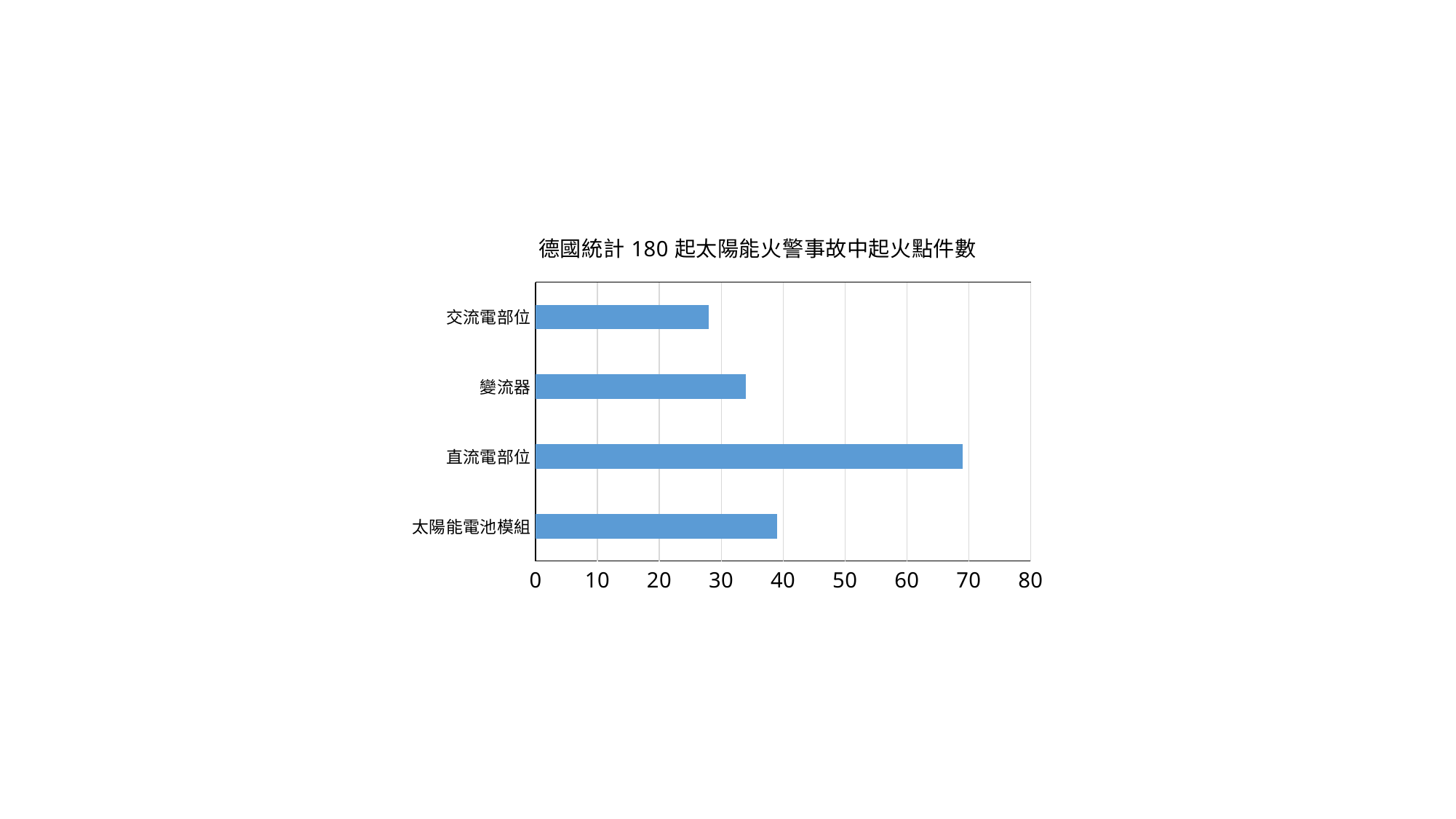
What is the title of the chart? 德國統計 180 起太陽能火警事故中起火點件數 Is the value for 直流電部位 greater or less than 60? greater Which category has the lowest value? 交流電部位 Which is larger, the value for 太陽能電池模組 or the value for 變流器? 太陽能電池模組 Which is larger, the value for 直流電部位 or the value for 太陽能電池模組? 直流電部位 What kind of chart is shown on the slide? bar chart Is the value for 交流電部位 greater or less than 30? less How many categories are plotted in the chart? 4 Is the value for 太陽能電池模組 greater or less than 30? greater What is the maximum value shown on the horizontal axis? 80 Which category has the highest value? 直流電部位